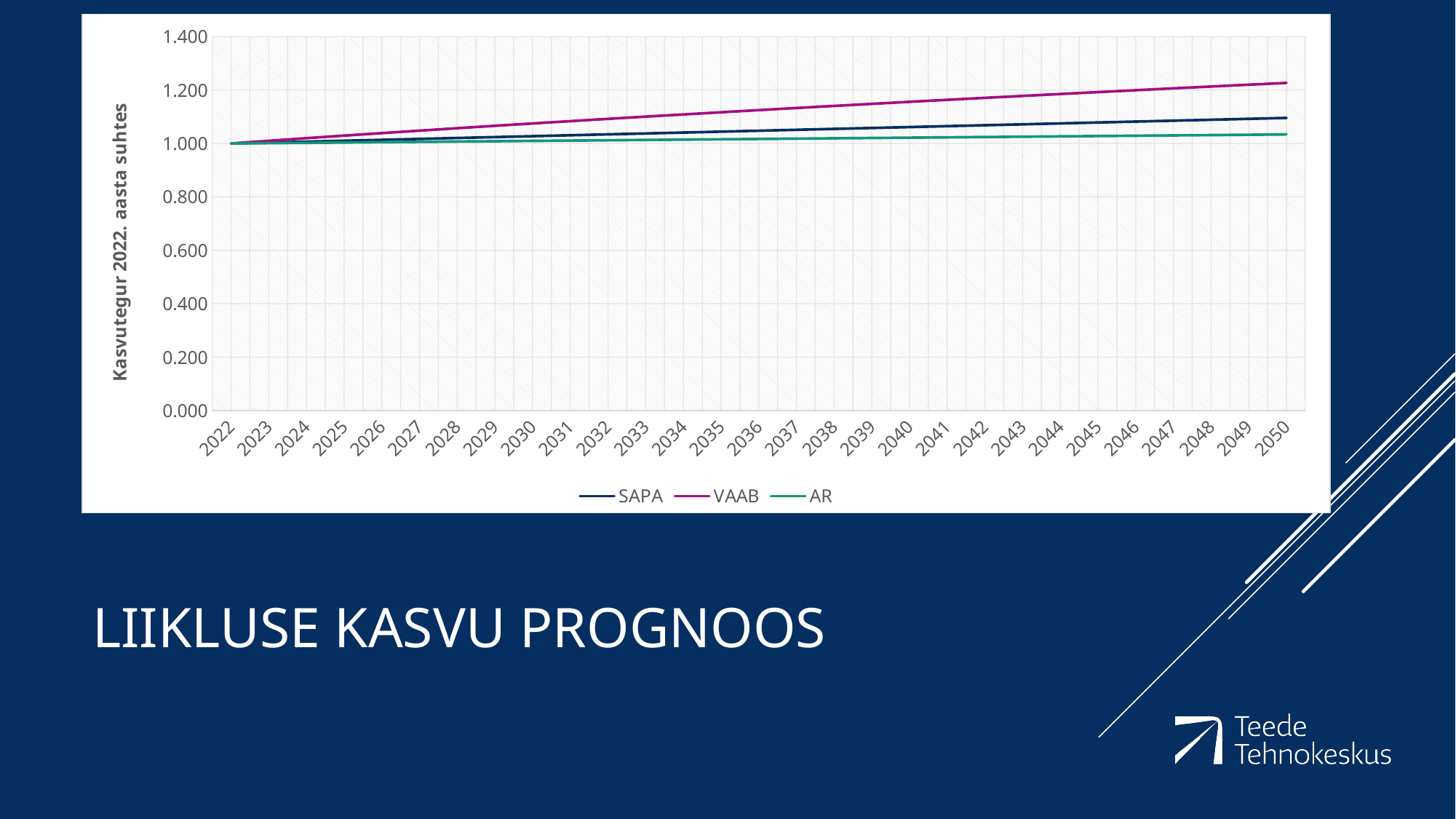
Which series has the lowest value in 2050? AR How many years are shown on the x axis? 29 Is the value for AR in 2050 greater or less than 1.200? less What kind of chart is shown on the slide? line chart What is the title of the y axis? Kasvutegur 2022. aasta suhtes Is the value for SAPA in 2050 greater or less than 1.200? less Do the values of the VAAB series rise or fall from 2022 to 2050? rise Is the value for VAAB in 2050 greater or less than 1.000? greater How many series does the legend list? 3 What is the value of the SAPA series in 2022? 1.000 Which series has the highest value in 2050? VAAB Which is larger in 2040, the value for SAPA or the value for AR? SAPA